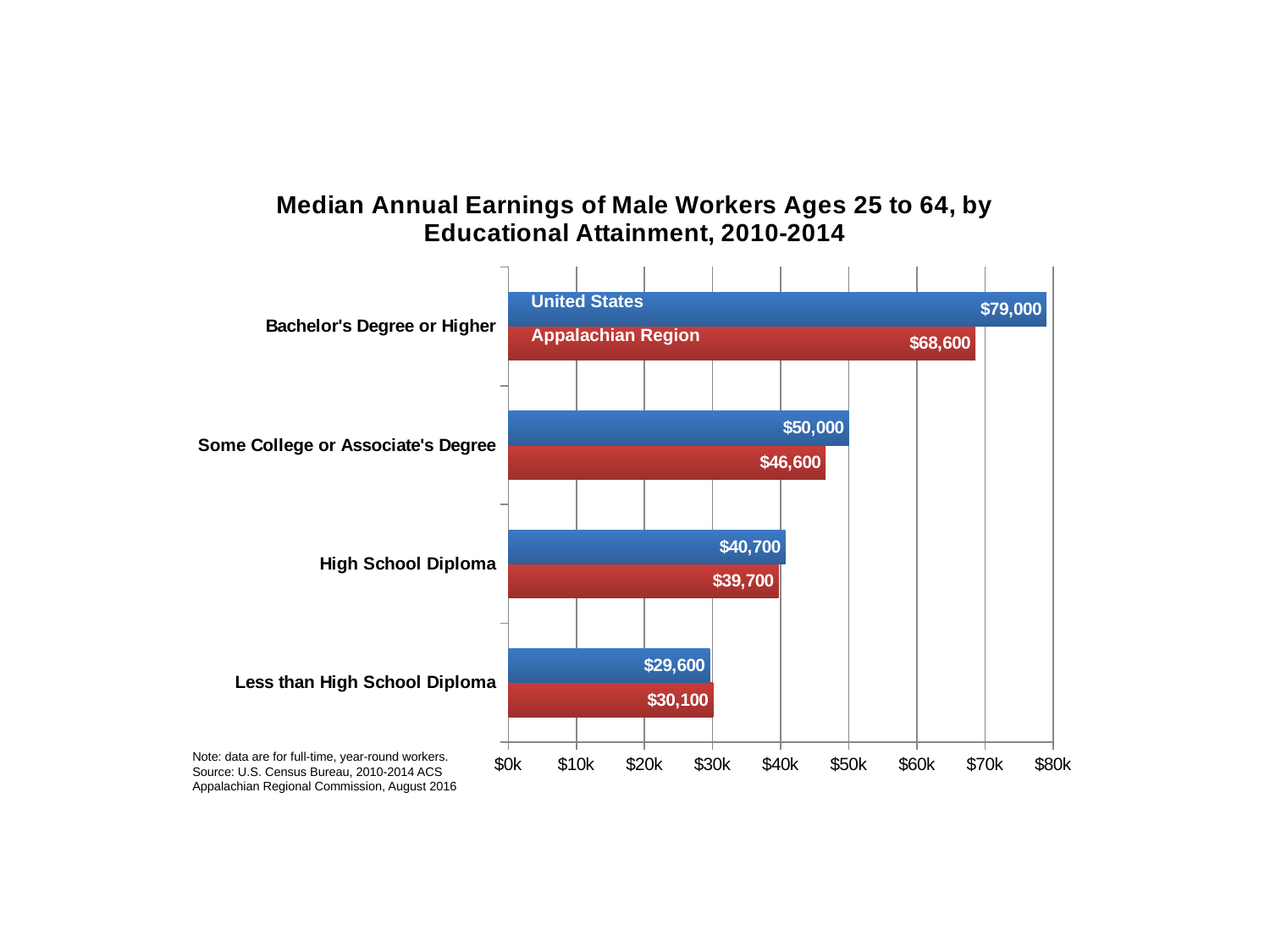
Is the United States value for Some College or Associate's Degree greater or less than $40k? greater What is the median annual earnings for Appalachian Region male workers with a High School Diploma? $39,700 What is the median annual earnings for United States male workers with a Bachelor's Degree or Higher? $79,000 How many series does the chart show? 2 What is the difference between United States and Appalachian Region median earnings for workers with a Bachelor's Degree or Higher? $10,400 What kind of chart is shown on the slide? Bar chart Which educational attainment category has the lowest median annual earnings for the Appalachian Region? Less than High School Diploma For workers with Less than High School Diploma, which is larger: the United States value or the Appalachian Region value? Appalachian Region How many educational attainment categories are shown on the chart? 4 What is the median annual earnings for Appalachian Region male workers with Some College or Associate's Degree? $46,600 Which colour represents the Appalachian Region series? Red Which educational attainment category has the highest median annual earnings for the United States? Bachelor's Degree or Higher